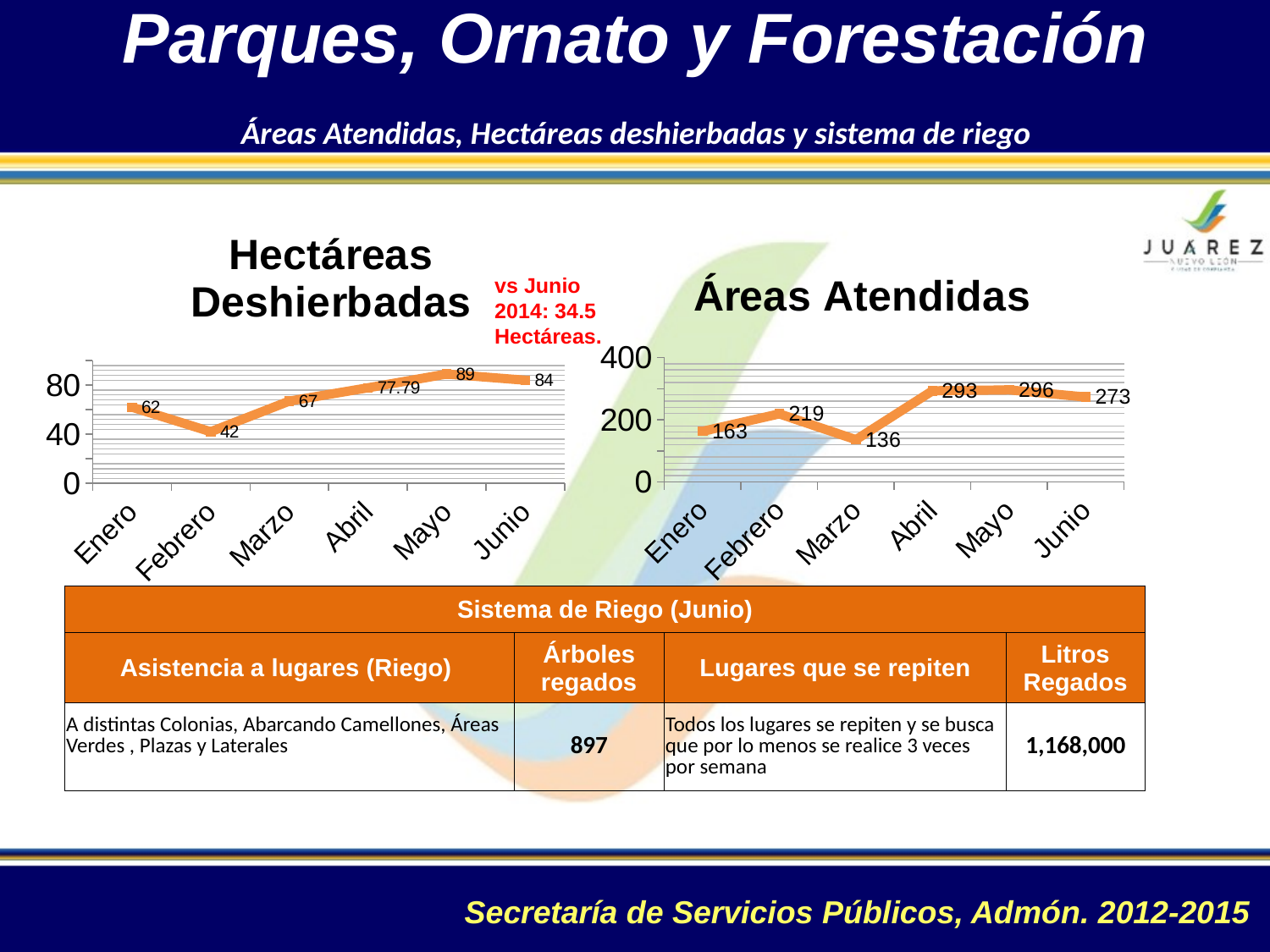
What type of chart is the Áreas Atendidas chart? Line chart In the Hectáreas Deshierbadas chart, which month has the lowest value? Febrero In the Hectáreas Deshierbadas chart, how many months are plotted? 6 In the Áreas Atendidas chart, which month has the highest value? Mayo In the Hectáreas Deshierbadas chart, what is the value for Abril? 77.79 In the Hectáreas Deshierbadas chart, what is the difference between the values for Mayo and Junio? 5 In the Áreas Atendidas chart, what is the difference between the values for Abril and Marzo? 157 In the Áreas Atendidas chart, which is larger, the value for Enero or the value for Junio? Junio In the Áreas Atendidas chart, which month has the lowest value? Marzo In the Áreas Atendidas chart, is the value for Enero greater or less than 200? less In the Hectáreas Deshierbadas chart, which month has the highest value? Mayo In the Áreas Atendidas chart, what is the value for Febrero? 219